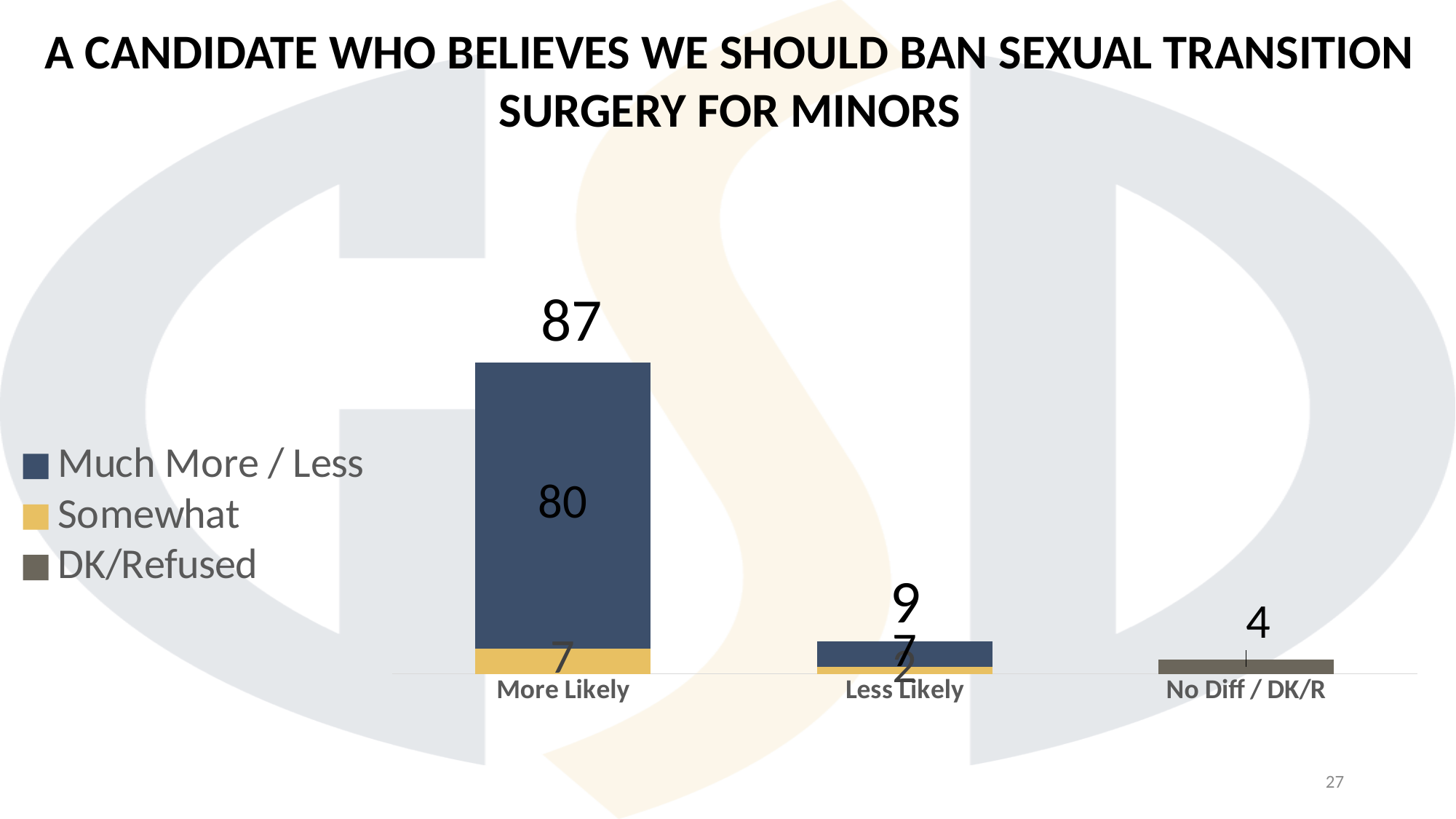
What is the Much More / Less value for More Likely? 80 What is the difference between the More Likely total and the Less Likely total? 78 What is the Somewhat value for More Likely? 7 Which category has the highest total? More Likely How many series does the legend list? 3 Which is larger, the Less Likely total or the No Diff / DK/R value? Less Likely What type of chart is shown on the slide? bar chart What is the value for No Diff / DK/R? 4 What is the total value shown above the Less Likely bar? 9 What is the total value shown above the More Likely bar? 87 Which category has the lowest total? No Diff / DK/R How many categories are shown on the x axis? 3